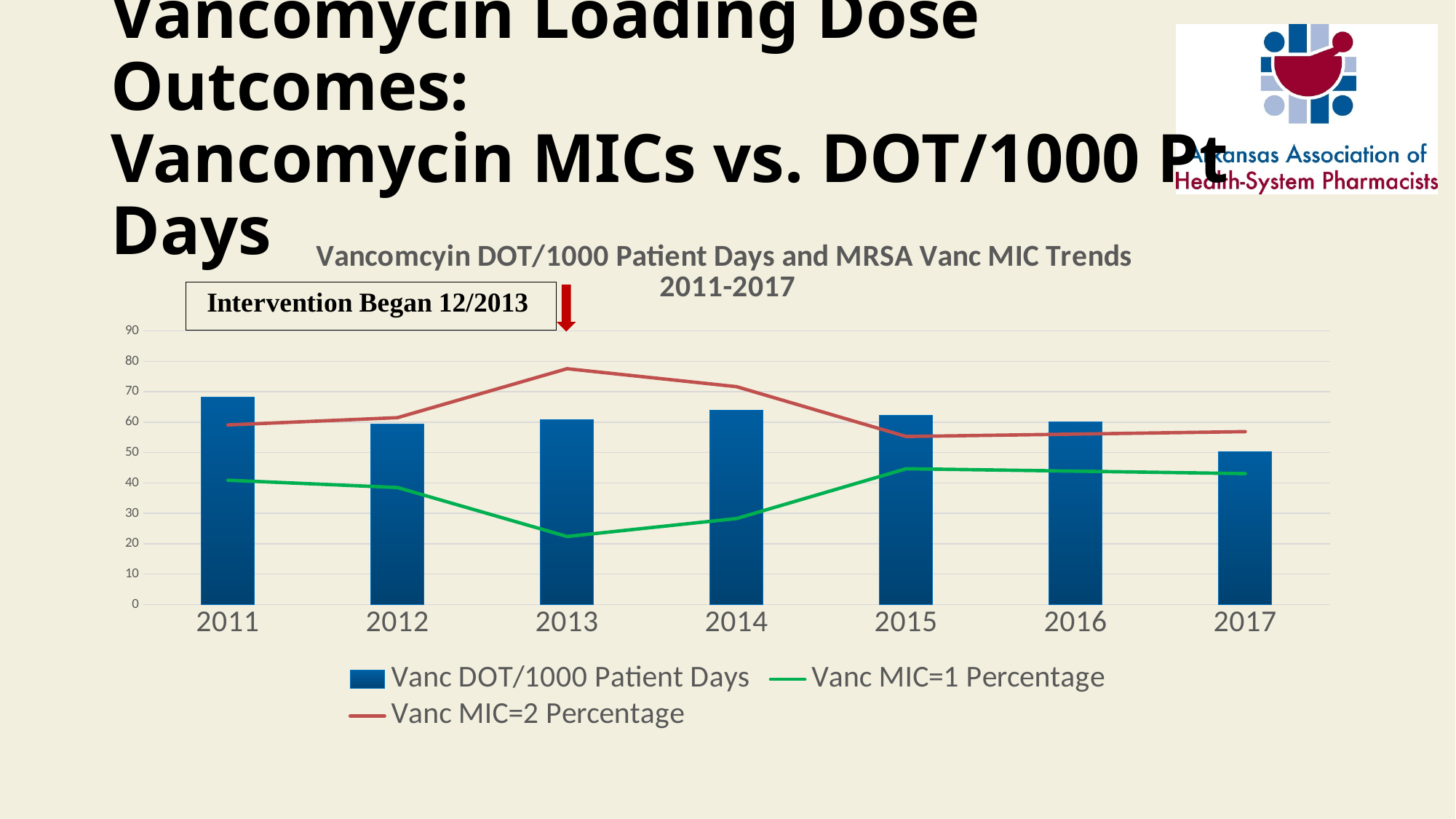
In which year is the Vanc DOT/1000 Patient Days bar the lowest? 2017 Is the Vanc MIC=2 Percentage value for 2013 greater or less than 70? greater In which year does the Vanc MIC=1 Percentage line reach its lowest point? 2013 How many series does the chart's legend list? 3 Is the Vanc DOT/1000 Patient Days value for 2017 greater or less than 60? less In which year does the Vanc MIC=2 Percentage line reach its highest point? 2013 According to the annotation on the chart, when did the intervention begin? 12/2013 Which year has the larger Vanc DOT/1000 Patient Days bar, 2011 or 2017? 2011 In which year is the Vanc DOT/1000 Patient Days bar the highest? 2011 How many years are shown on the x axis of the chart? 7 What kind of chart is shown on the slide? A combination bar and line chart Is the Vanc MIC=1 Percentage value for 2013 greater or less than 30? less